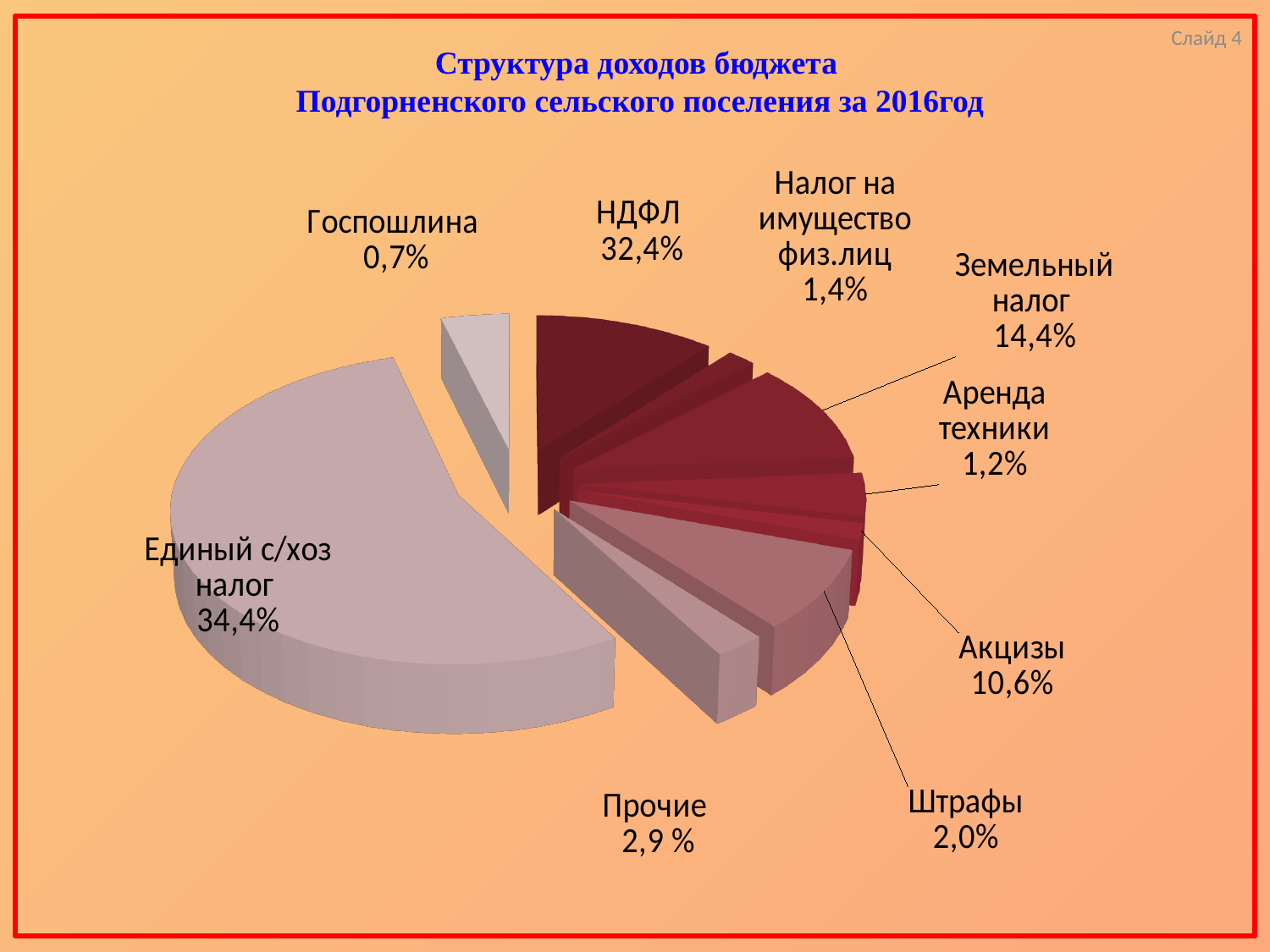
Which category has the smallest share of the pie? Госпошлина What is the value shown for Земельный налог? 14,4% What is the value shown for Госпошлина? 0,7% What percentage is shown for Акцизы? 10,6% How many categories are shown in the pie chart? 9 Which category has the largest share of the pie? Единый с/хоз налог What is the difference between the shares of Прочие and Штрафы? 0,9% Which is larger, the share of Земельный налог or the share of Акцизы? Земельный налог What share of the pie does НДФЛ account for? 32,4% What is the difference between the shares of Единый с/хоз налог and НДФЛ? 2,0% What is the title of the chart? Структура доходов бюджета Подгорненского сельского поселения за 2016год What kind of chart is shown on the slide? Pie chart